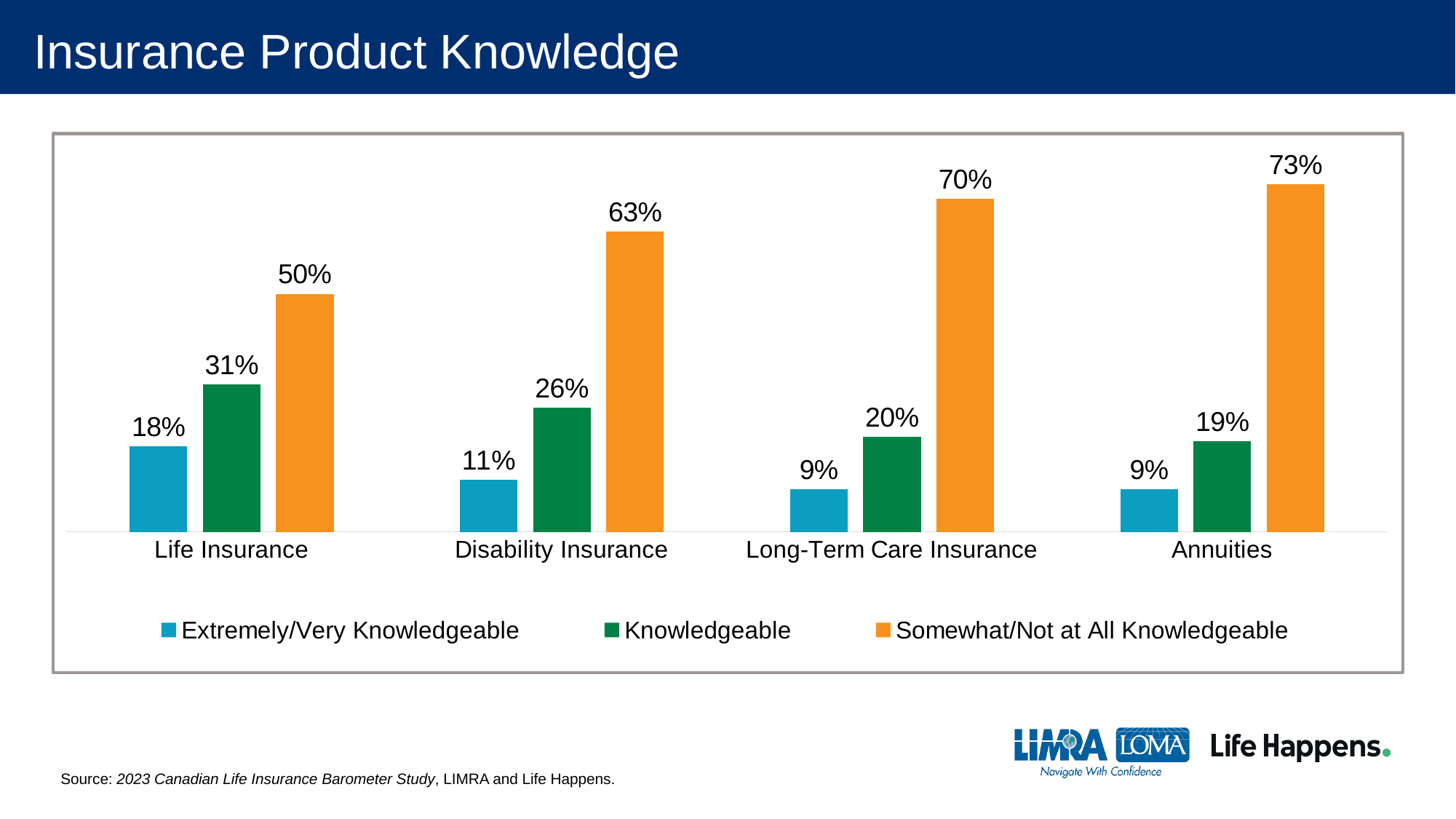
What is the Knowledgeable value for Disability Insurance? 26% Does the Somewhat/Not at All Knowledgeable series rise or fall from Life Insurance to Annuities? Rise How many insurance product categories are shown on the x axis? 4 How many series does the legend list? 3 What percentage of respondents are Extremely/Very Knowledgeable about Life Insurance? 18% What is the difference between the Somewhat/Not at All Knowledgeable values for Annuities and Life Insurance? 23% Which product has the lowest Knowledgeable percentage? Annuities Which product has the highest Somewhat/Not at All Knowledgeable percentage? Annuities What is the Somewhat/Not at All Knowledgeable value for Annuities? 73% Which colour represents the Knowledgeable series in the legend? Green What kind of chart is shown on the slide? Bar chart Which is larger: the Knowledgeable value for Life Insurance or for Long-Term Care Insurance? Life Insurance